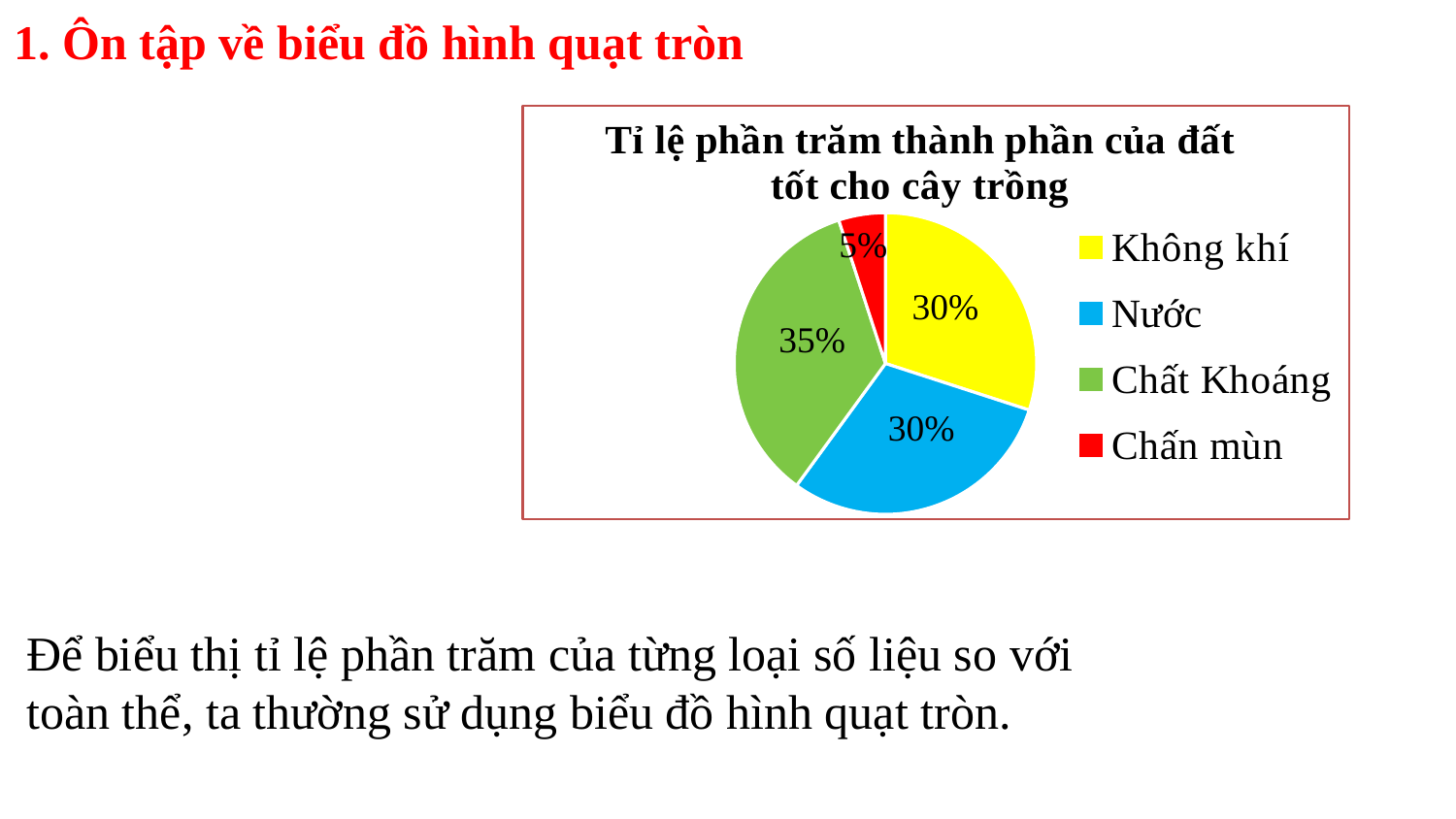
What kind of chart is shown on the slide? Pie chart What percentage of the pie is Nước? 30% How many categories does the legend list? 4 What percentage of the pie is Chấn mùn? 5% What is the difference between the shares of Chất Khoáng and Chấn mùn? 30% Which category has the smallest share of the pie? Chấn mùn Which is larger, the share of Chất Khoáng or the share of Nước? Chất Khoáng Which colour represents Nước in the chart? Blue What percentage of the pie is Chất Khoáng? 35% What percentage of the pie is Không khí? 30% What is the title of the chart? Tỉ lệ phần trăm thành phần của đất tốt cho cây trồng Which category has the largest share of the pie? Chất Khoáng